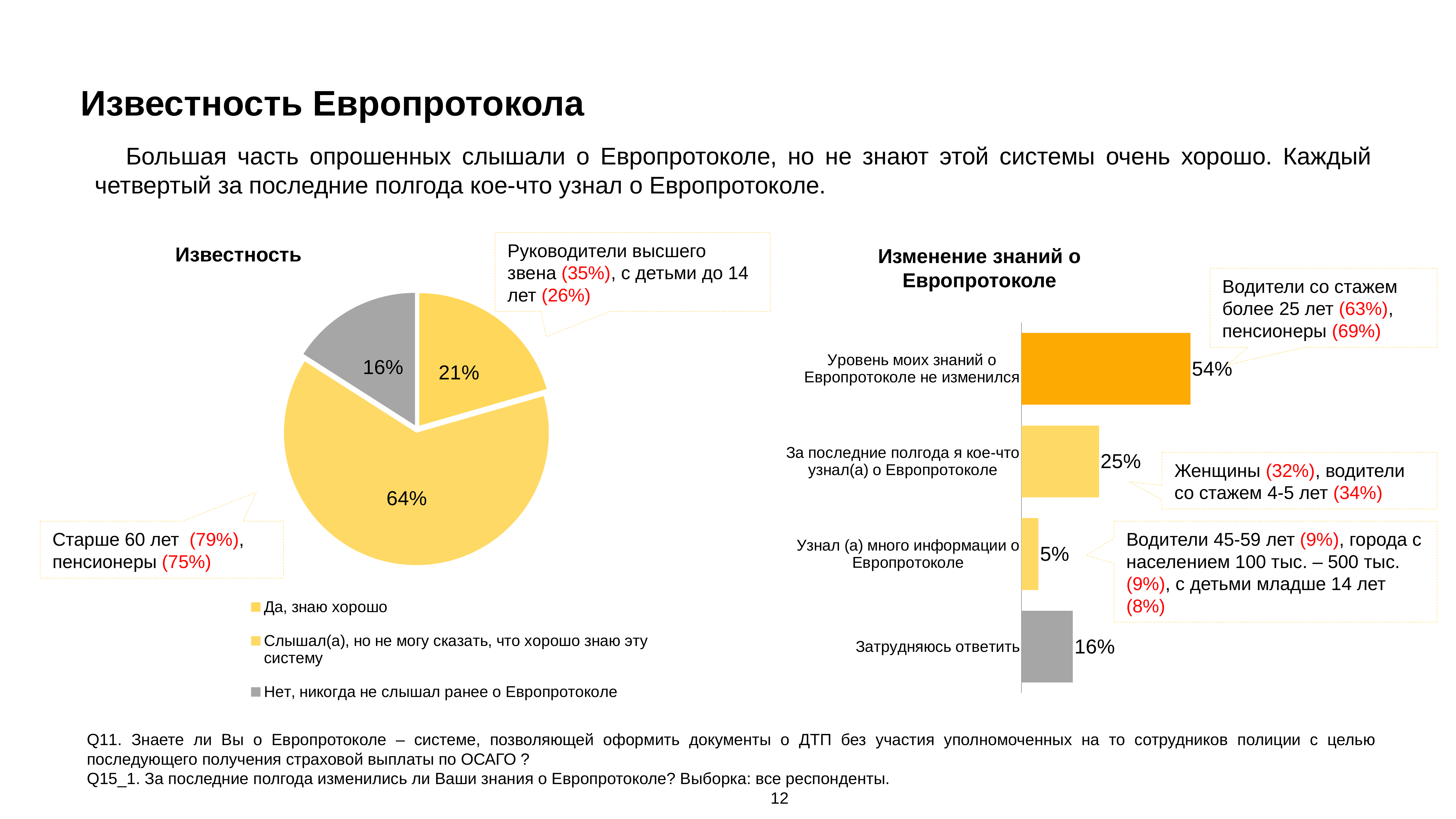
In the chart "Изменение знаний о Европротоколе", which category has the lowest value? Узнал(а) много информации о Европротоколе In the chart "Изменение знаний о Европротоколе", which is larger: "За последние полгода я кое-что узнал(а) о Европротоколе" or "Затрудняюсь ответить"? За последние полгода я кое-что узнал(а) о Европротоколе In the pie chart "Известность", what share of respondents answered "Да, знаю хорошо"? 21% In the chart "Изменение знаний о Европротоколе", what is the value for "Узнал(а) много информации о Европротоколе"? 5% In the pie chart "Известность", how many slices are there? 3 What type of chart is "Изменение знаний о Европротоколе"? Bar chart In the pie chart "Известность", what is the difference between the share for "Слышал(а), но не могу сказать, что хорошо знаю эту систему" and the share for "Да, знаю хорошо"? 43% In the chart "Изменение знаний о Европротоколе", what is the value for "Уровень моих знаний о Европротоколе не изменился"? 54% In the pie chart "Известность", which answer has the largest share? Слышал(а), но не могу сказать, что хорошо знаю эту систему In the pie chart "Известность", which answer has the smallest share? Нет, никогда не слышал ранее о Европротоколе In the chart "Изменение знаний о Европротоколе", what is the difference between "Уровень моих знаний о Европротоколе не изменился" and "За последние полгода я кое-что узнал(а) о Европротоколе"? 29% In the pie chart "Известность", what share of respondents answered "Нет, никогда не слышал ранее о Европротоколе"? 16%